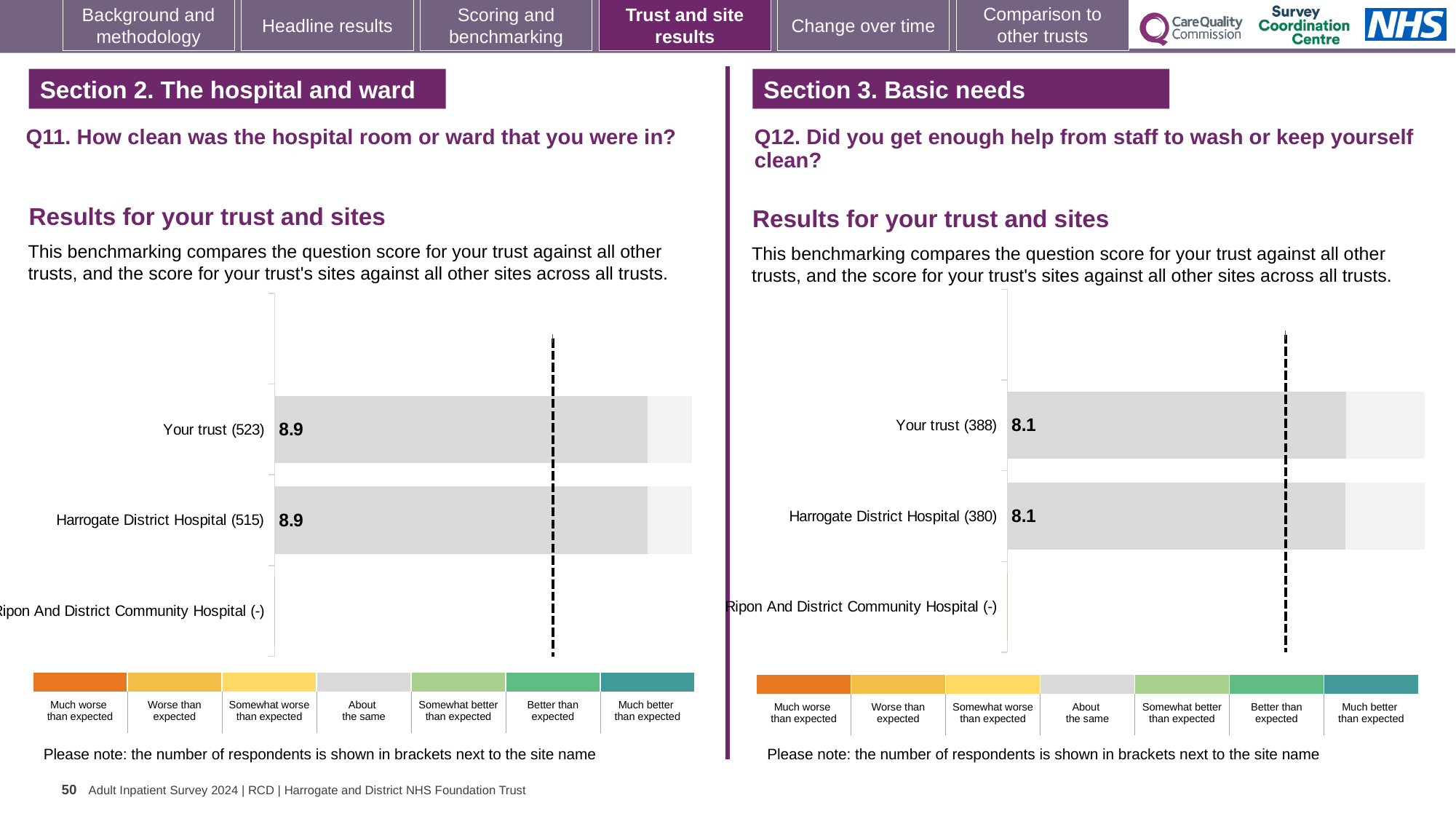
What kind of chart is the Q11 chart on the left? Bar chart In the Q12 chart on the right, what is the difference between the scores for Your trust and Harrogate District Hospital? 0 How many categories are listed on the y axis of the Q12 chart on the right? 3 In the Q11 chart on the left, what is the difference between the scores for Your trust and Harrogate District Hospital? 0 In the Q11 chart on the left, how many respondents are shown in brackets for Your trust? 523 How many categories are listed on the y axis of the Q11 chart on the left? 3 In the Q12 chart on the right, what is the score for Harrogate District Hospital? 8.1 In the Q12 chart on the right, how many respondents are shown in brackets for Harrogate District Hospital? 380 In the Q12 chart on the right, what is the score for Your trust? 8.1 In the Q11 chart on the left, what is the score for Your trust? 8.9 Is the score for Your trust in the Q11 chart on the left larger than the score for Your trust in the Q12 chart on the right? Yes In the Q11 chart on the left, what is the score for Harrogate District Hospital? 8.9